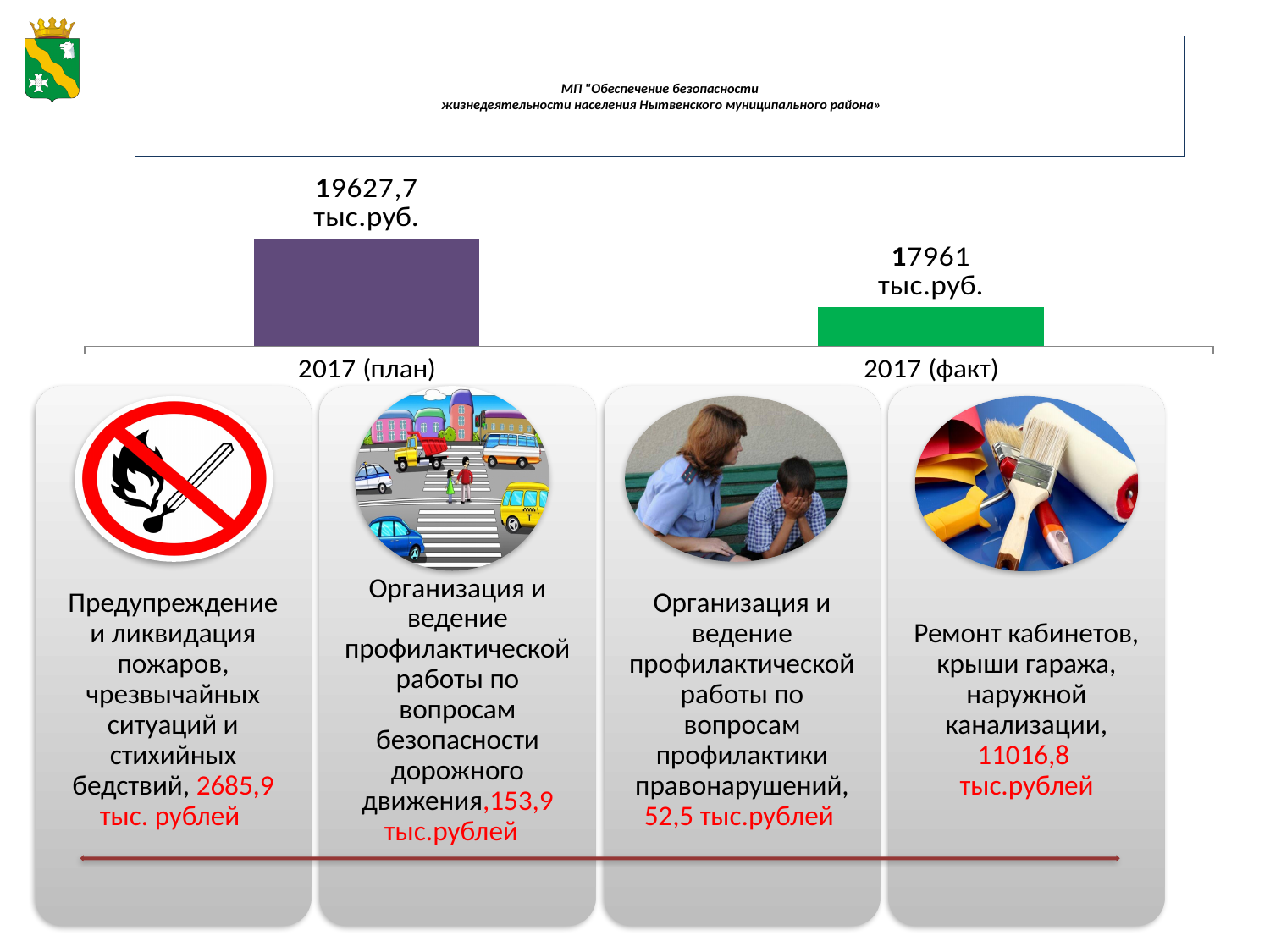
Is the value for 2017 (план) larger or smaller than the value for 2017 (факт)? larger What is the value shown for 2017 (факт)? 17961 тыс.руб. Which category has the higher value, 2017 (план) or 2017 (факт)? 2017 (план) What is the difference between the 2017 (план) value and the 2017 (факт) value, in тыс.руб.? 1666,7 What colour is the bar for 2017 (факт)? green Which category has the lowest value in the chart? 2017 (факт) What is the value shown for 2017 (план)? 19627,7 тыс.руб. How many bars are plotted in the chart? 2 What kind of chart is shown on the slide? bar chart What colour is the bar for 2017 (план)? purple Do the values rise or fall from 2017 (план) to 2017 (факт)? fall